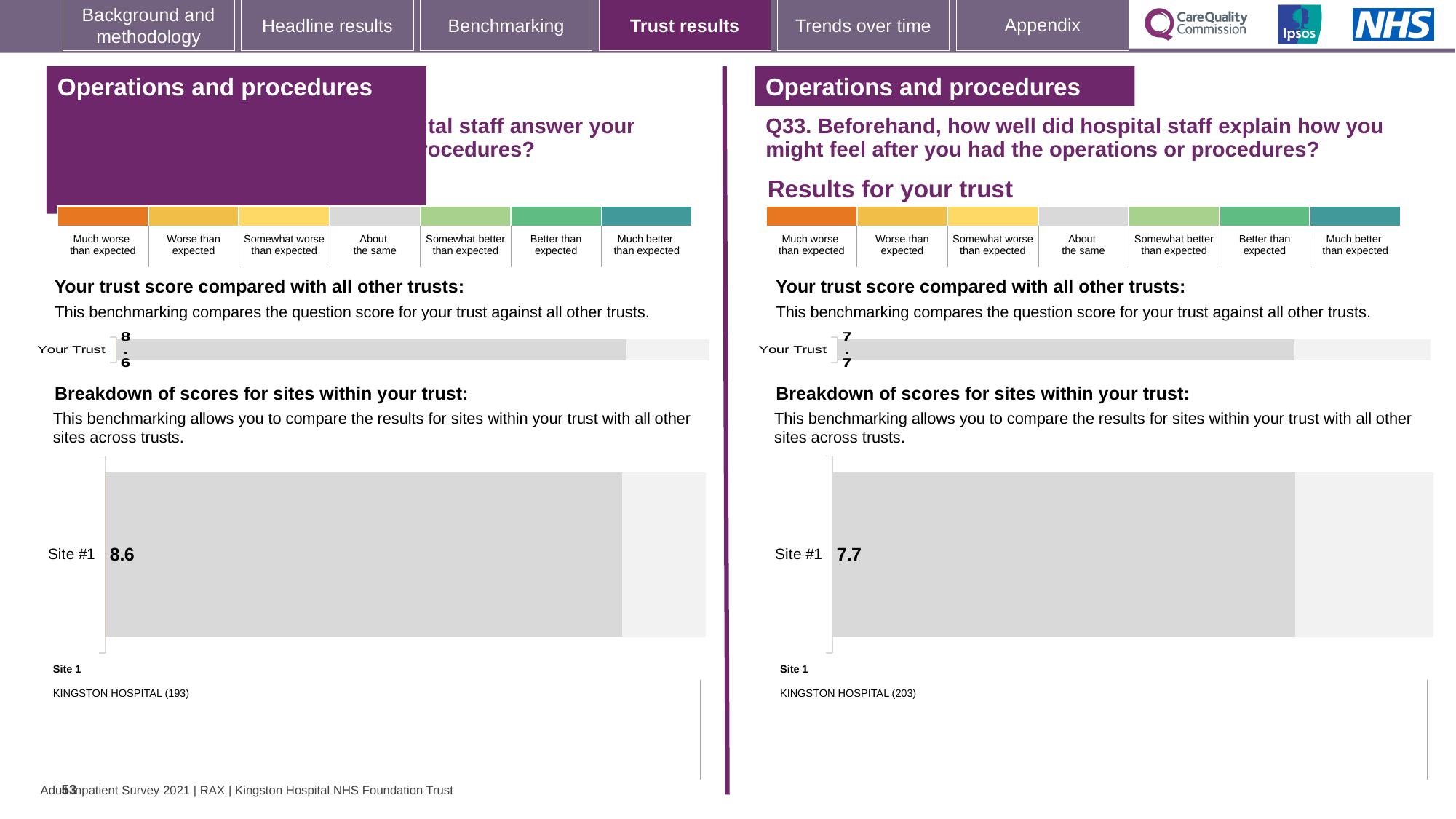
How many sites are shown in the site breakdown chart on the right-hand side for Q33? 1 On the left-hand side, which hospital is listed as Site 1? KINGSTON HOSPITAL (193) What is the difference between the Site #1 score on the left-hand chart and the Site #1 score on the right-hand chart for Q33? 0.9 On the left-hand chart, what is the score shown for Your Trust? 8.6 On the left-hand chart, what is the score shown for Site #1? 8.6 What kind of chart is used to show the Site #1 score on the right-hand side for Q33? Bar chart Which is larger: the Site #1 score on the left-hand chart or the Site #1 score on the right-hand chart for Q33? Left-hand chart (8.6) On the right-hand side for Q33, which hospital is listed as Site 1? KINGSTON HOSPITAL (203) On the right-hand chart for Q33, is the Site #1 score greater or less than the Your Trust score, or are they equal? Equal How many sites are shown in the site breakdown chart on the left-hand side? 1 On the right-hand chart for Q33, what is the score shown for Site #1? 7.7 On the right-hand chart for Q33, what is the score shown for Your Trust? 7.7